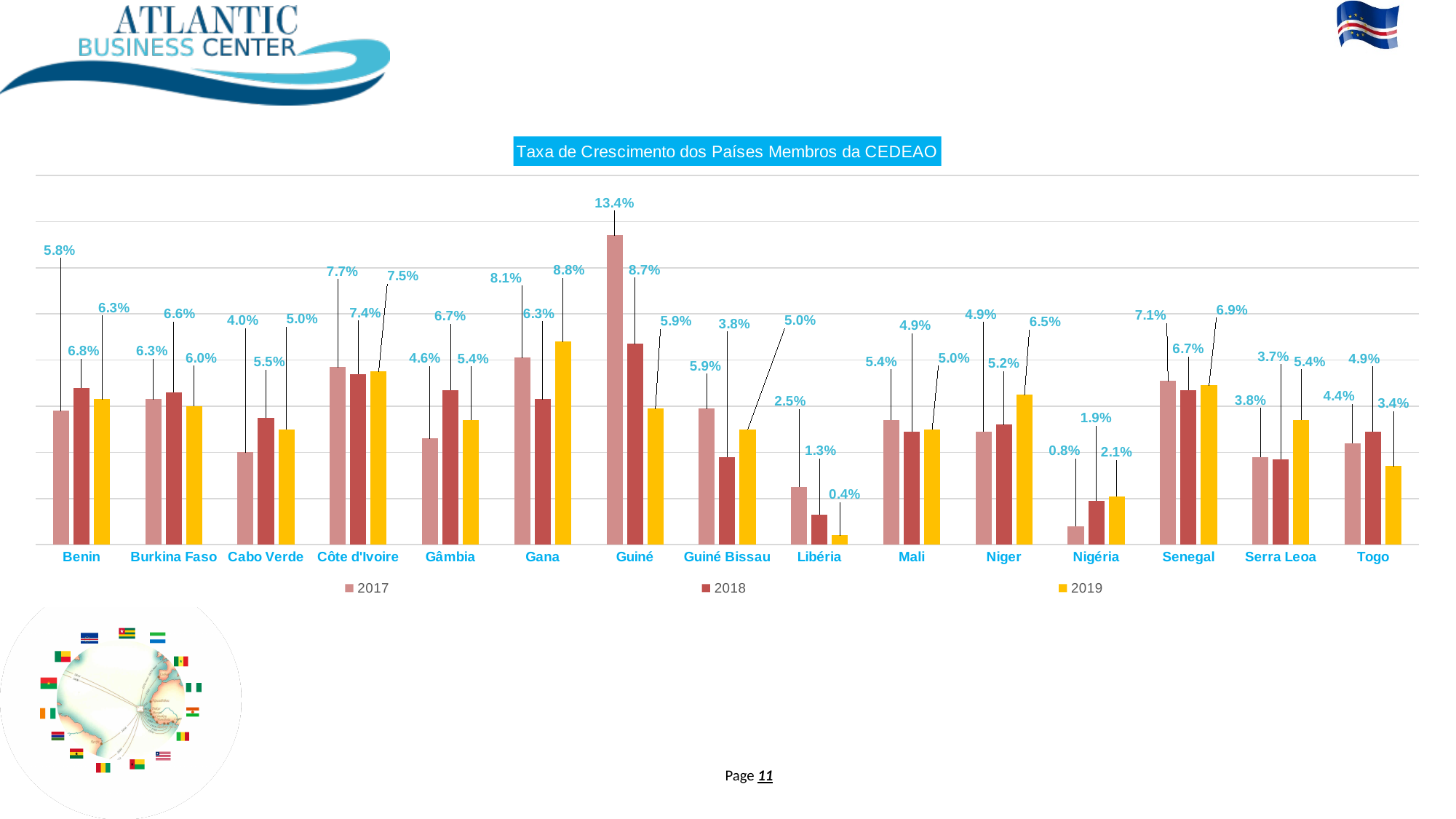
What is the 2017 value for Guiné? 13.4% Which is larger, the 2019 value for Niger or the 2019 value for Mali? Niger How many series does the legend list? 3 What is the 2018 value for Nigéria? 1.9% What is the 2019 value for Gana? 8.8% How many countries are shown on the x axis? 15 Which country has the lowest 2019 value? Libéria What kind of chart is shown on the slide? Bar chart What is the title of the chart? Taxa de Crescimento dos Países Membros da CEDEAO What is the difference between the 2017 and 2018 values for Guiné? 4.7% What is the difference between the 2019 values for Gana and Togo? 5.4% Which country has the highest 2017 value? Guiné